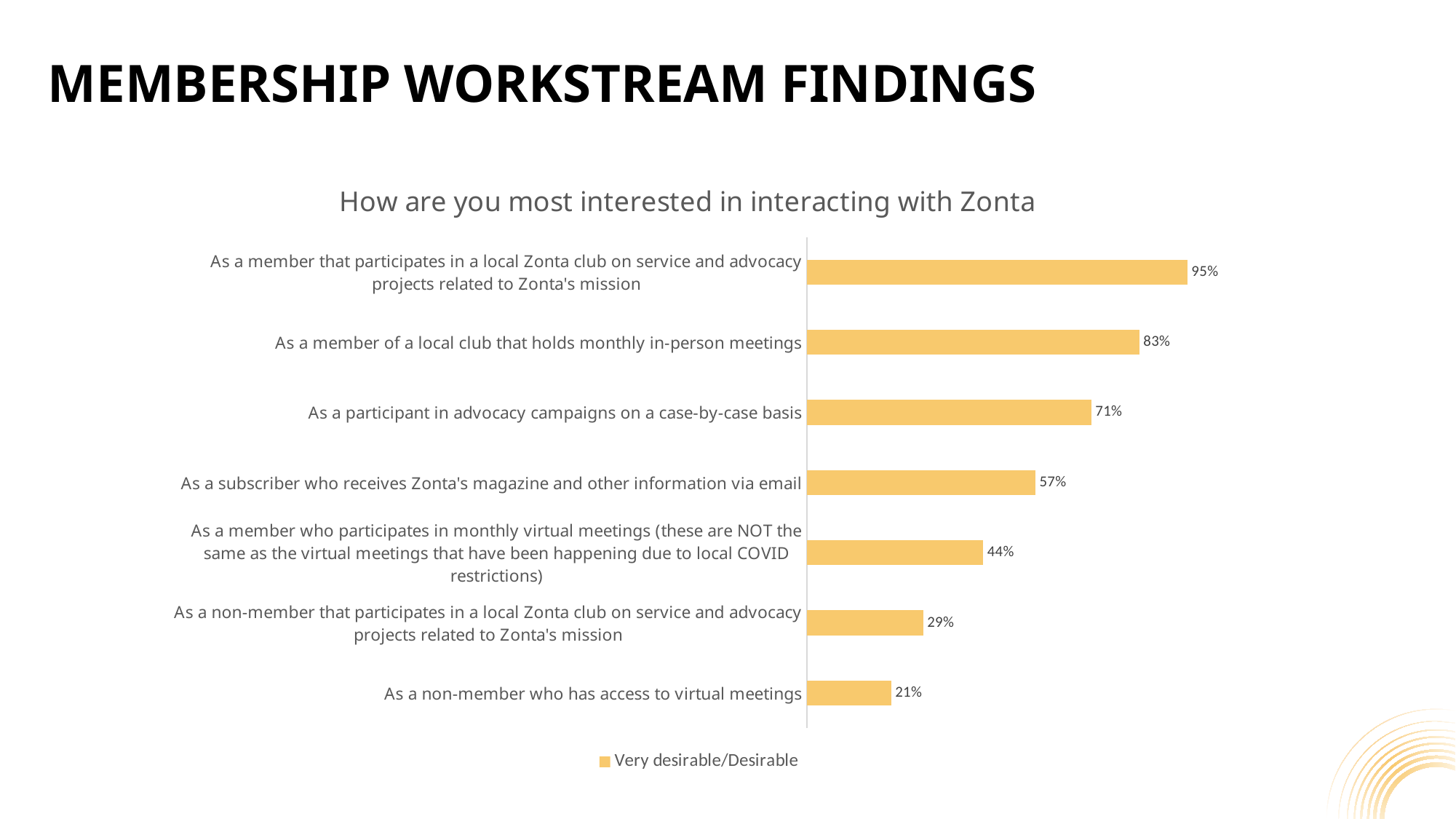
Which category has the lowest value? As a non-member who has access to virtual meetings Which is larger: the value for 'As a non-member that participates in a local Zonta club on service and advocacy projects' or 'As a non-member who has access to virtual meetings'? As a non-member that participates in a local Zonta club on service and advocacy projects related to Zonta's mission What kind of chart is shown on the slide? Bar chart Which category has the highest value? As a member that participates in a local Zonta club on service and advocacy projects related to Zonta's mission What is the legend entry shown below the chart? Very desirable/Desirable What is the difference between the value for 'As a participant in advocacy campaigns on a case-by-case basis' and 'As a member who participates in monthly virtual meetings'? 27% What percentage is shown for 'As a member of a local club that holds monthly in-person meetings'? 83% How many series does the legend list? 1 What percentage is shown for 'As a non-member who has access to virtual meetings'? 21% What is the title of the chart? How are you most interested in interacting with Zonta How many categories are shown in the chart? 7 What is the value for 'As a subscriber who receives Zonta's magazine and other information via email'? 57%